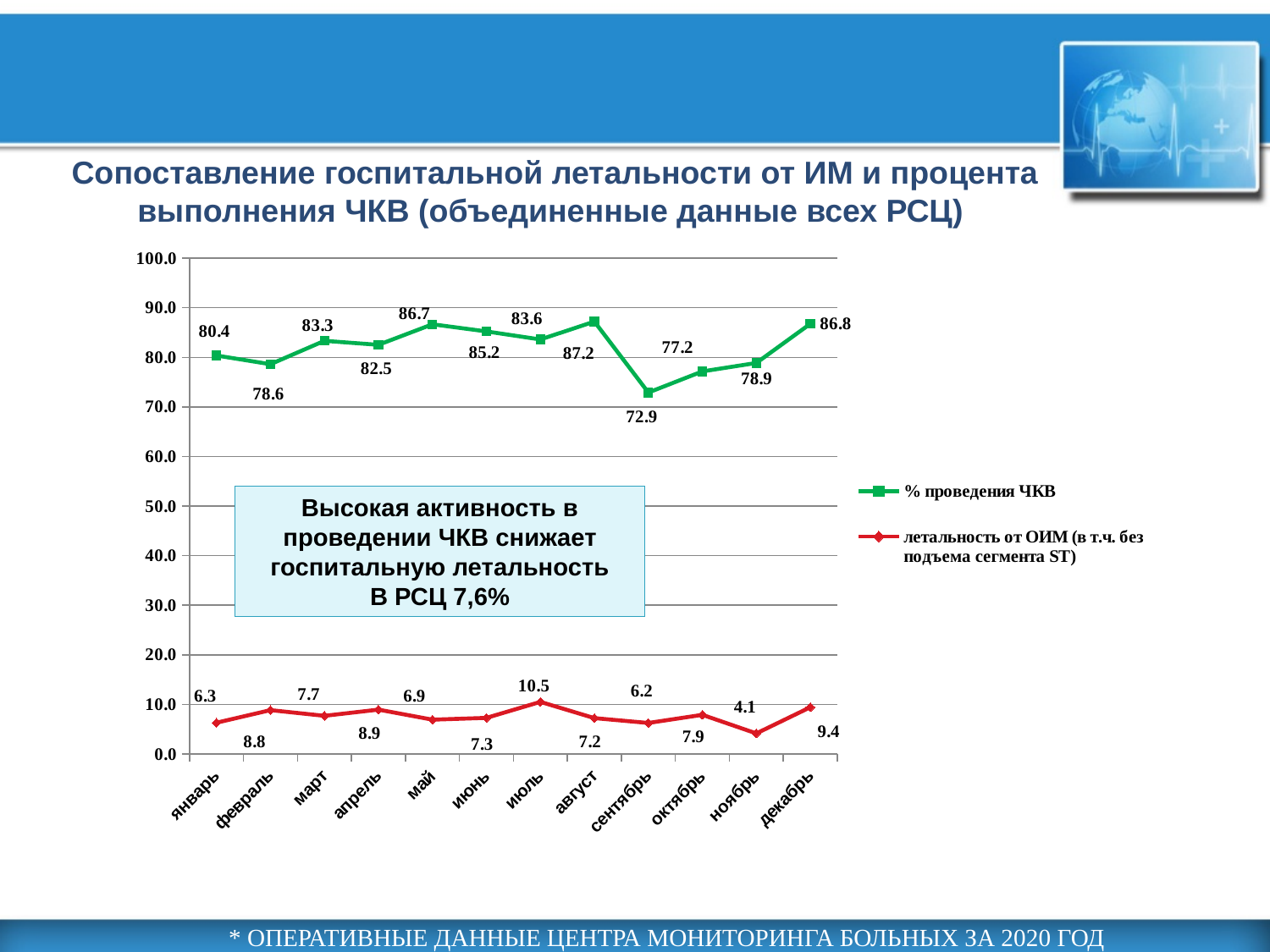
How many series does the legend list? 2 What is the value of летальность от ОИМ for июль? 10.5 How many months are shown on the x axis? 12 What is the difference between % проведения ЧКВ in август and in сентябрь? 14.3 In which month is % проведения ЧКВ highest? август What is the value of % проведения ЧКВ for май? 86.7 What kind of chart is shown on the slide? line chart In which month is летальность от ОИМ highest? июль What is the value of летальность от ОИМ for ноябрь? 4.1 In which month is % проведения ЧКВ lowest? сентябрь Which is larger, летальность от ОИМ in февраль or in март? февраль What is the value of % проведения ЧКВ for сентябрь? 72.9